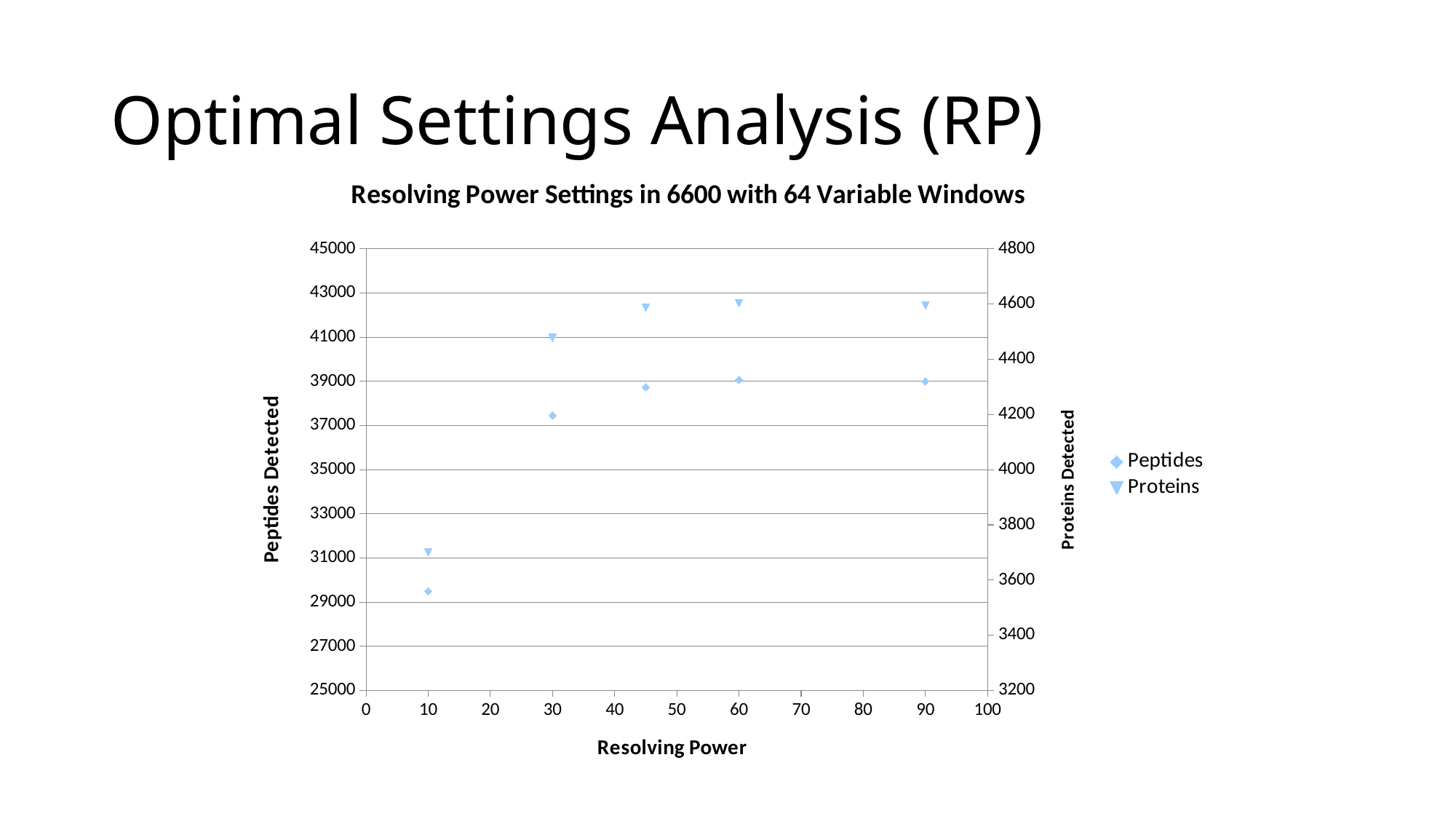
At which resolving power is the number of Peptides Detected lowest? 10 Is the Proteins Detected value at resolving power 30 greater or less than 4400? greater How many data points are plotted for the Peptides series? 5 Is the Proteins Detected value at resolving power 10 greater or less than 3800? less Is the Peptides Detected value at resolving power 60 greater or less than 37000? greater Which has more Peptides Detected: resolving power 10 or resolving power 30? 30 How many series does the legend list? 2 Do the Peptides Detected values generally rise or fall as resolving power increases from 10 to 60? rise What is the title of the chart? Resolving Power Settings in 6600 with 64 Variable Windows What kind of chart is shown on the slide? scatter chart At which resolving power is the number of Proteins Detected lowest? 10